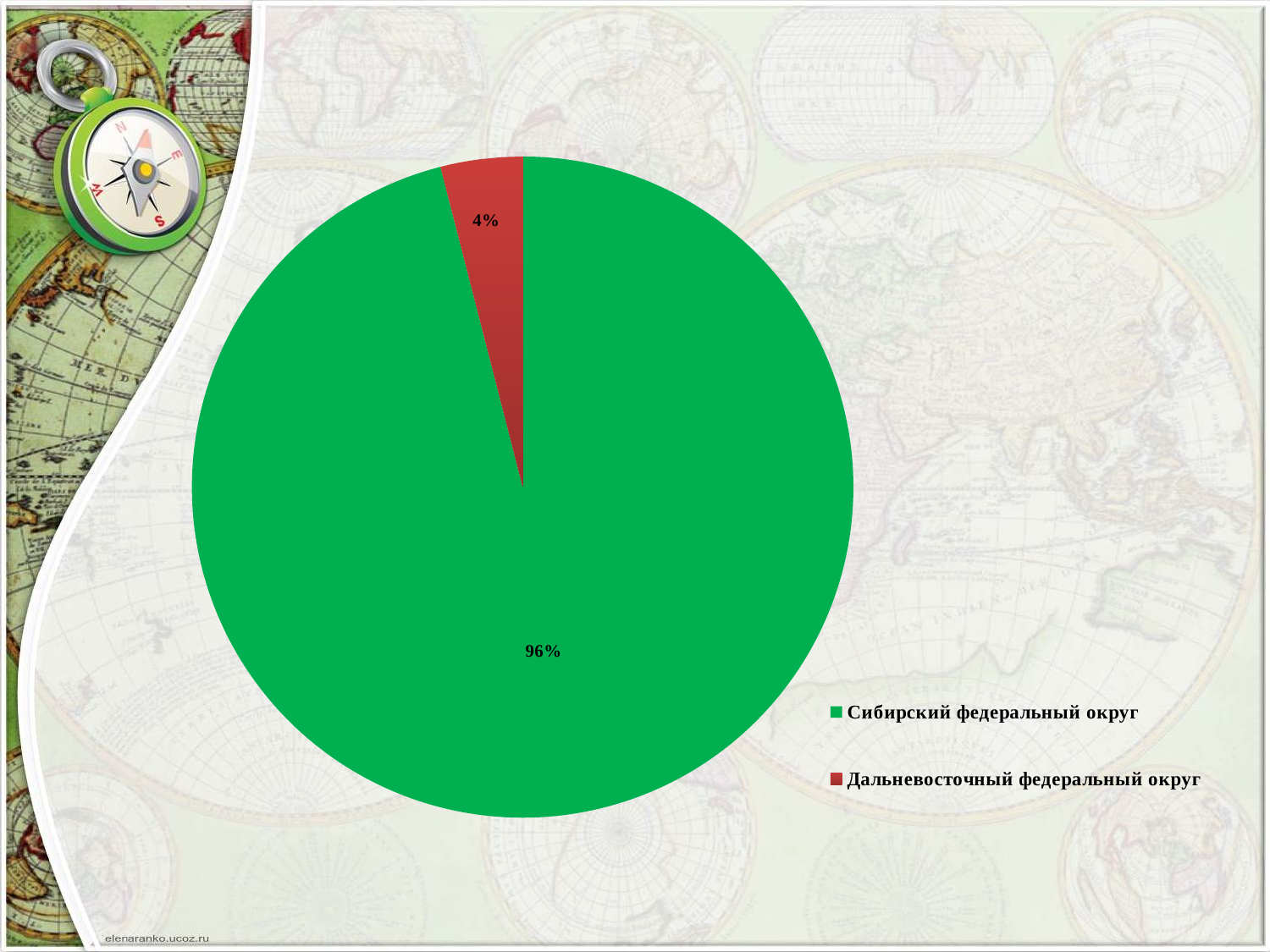
Which is larger: the slice for Сибирский федеральный округ or the slice for Дальневосточный федеральный округ? Сибирский федеральный округ What is the difference in percentage points between the Сибирский федеральный округ slice and the Дальневосточный федеральный округ slice? 92 Which category has the smallest slice of the pie? Дальневосточный федеральный округ How many entries does the legend list? 2 What colour is the slice for Сибирский федеральный округ? green Which category has the largest slice of the pie? Сибирский федеральный округ What share of the pie does Дальневосточный федеральный округ have? 4% What kind of chart is shown on the slide? pie chart What colour is the slice for Дальневосточный федеральный округ? red How many slices does the pie chart have? 2 What share of the pie does Сибирский федеральный округ have? 96%